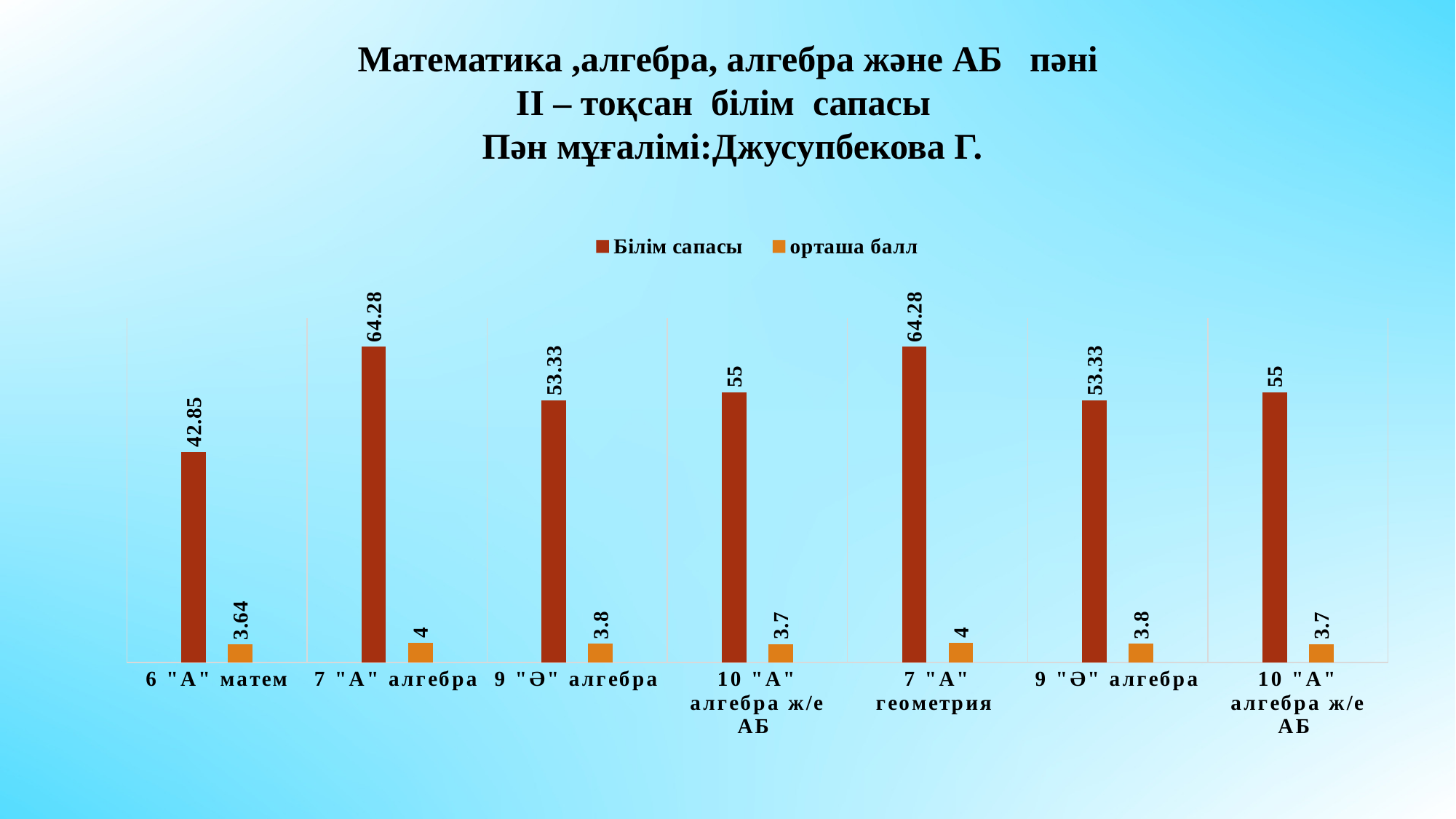
Which category has the lowest Білім сапасы value? 6 "А" матем What is the highest Білім сапасы value shown on the chart? 64.28 How many series does the legend list? 2 What is the Білім сапасы value for 6 "А" матем? 42.85 Which has a larger Білім сапасы value, 7 "А" алгебра or 6 "А" матем? 7 "А" алгебра What kind of chart is shown on the slide? Bar chart How many categories are shown on the x axis? 7 What is the орташа балл value for 7 "А" алгебра? 4 What is the difference between the Білім сапасы values for 7 "А" алгебра and 6 "А" матем? 21.43 What is the орташа балл value for 6 "А" матем? 3.64 What is the Білім сапасы value for 7 "А" геометрия? 64.28 What are the two series names listed in the legend? Білім сапасы and орташа балл